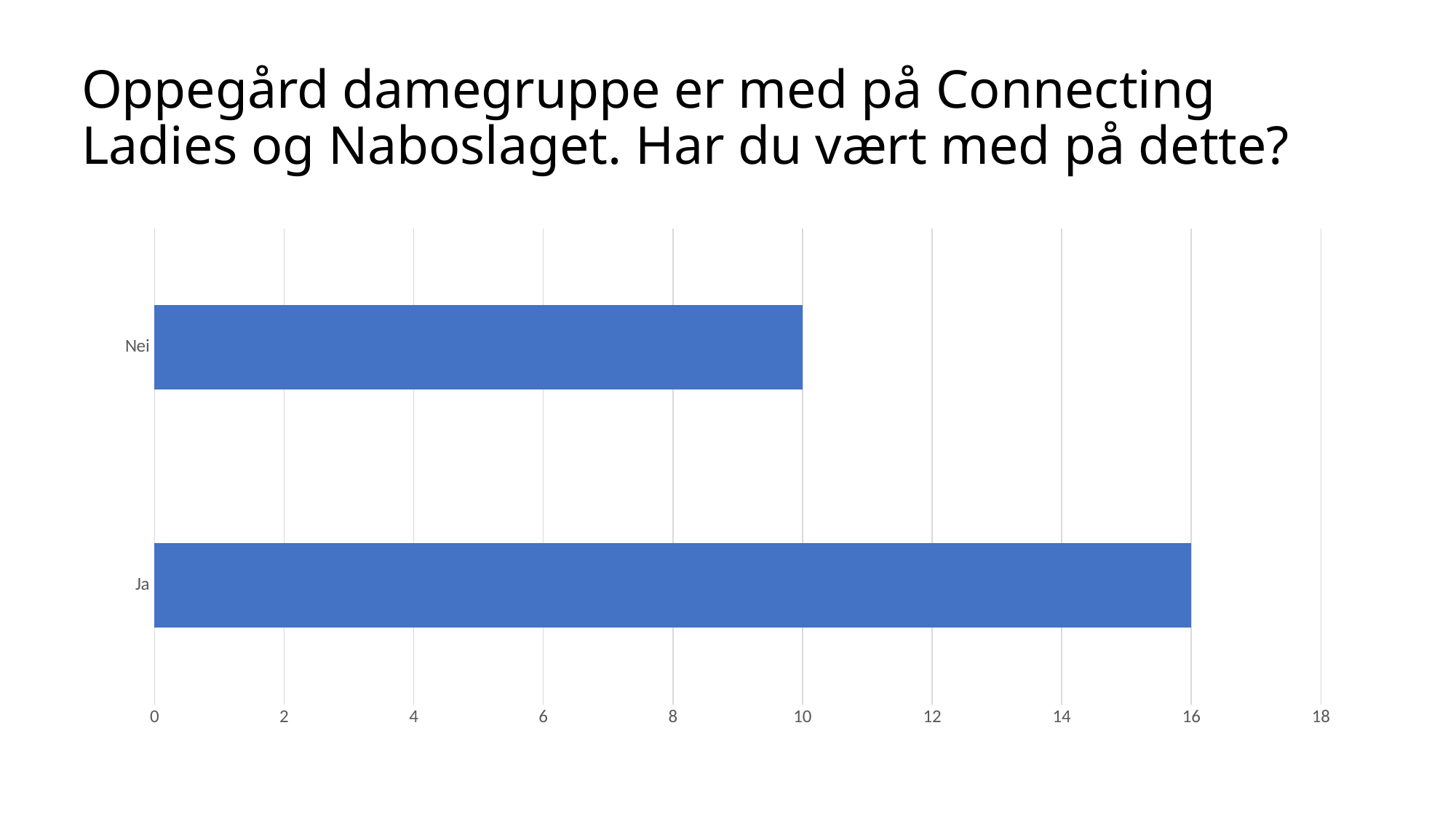
What is the difference between the values for Ja and Nei? 6 What is the highest value shown on the x axis? 18 What is the value for Ja? 16 What is the value for Nei? 10 What colour are the bars in the chart? blue How many categories are shown in the chart? 2 Which category has the highest value? Ja Which category has the lowest value? Nei What kind of chart is shown on the slide? bar chart Which is larger, the value for Ja or the value for Nei? Ja Is the value for Nei greater or less than 12? less Is the value for Ja greater or less than 14? greater